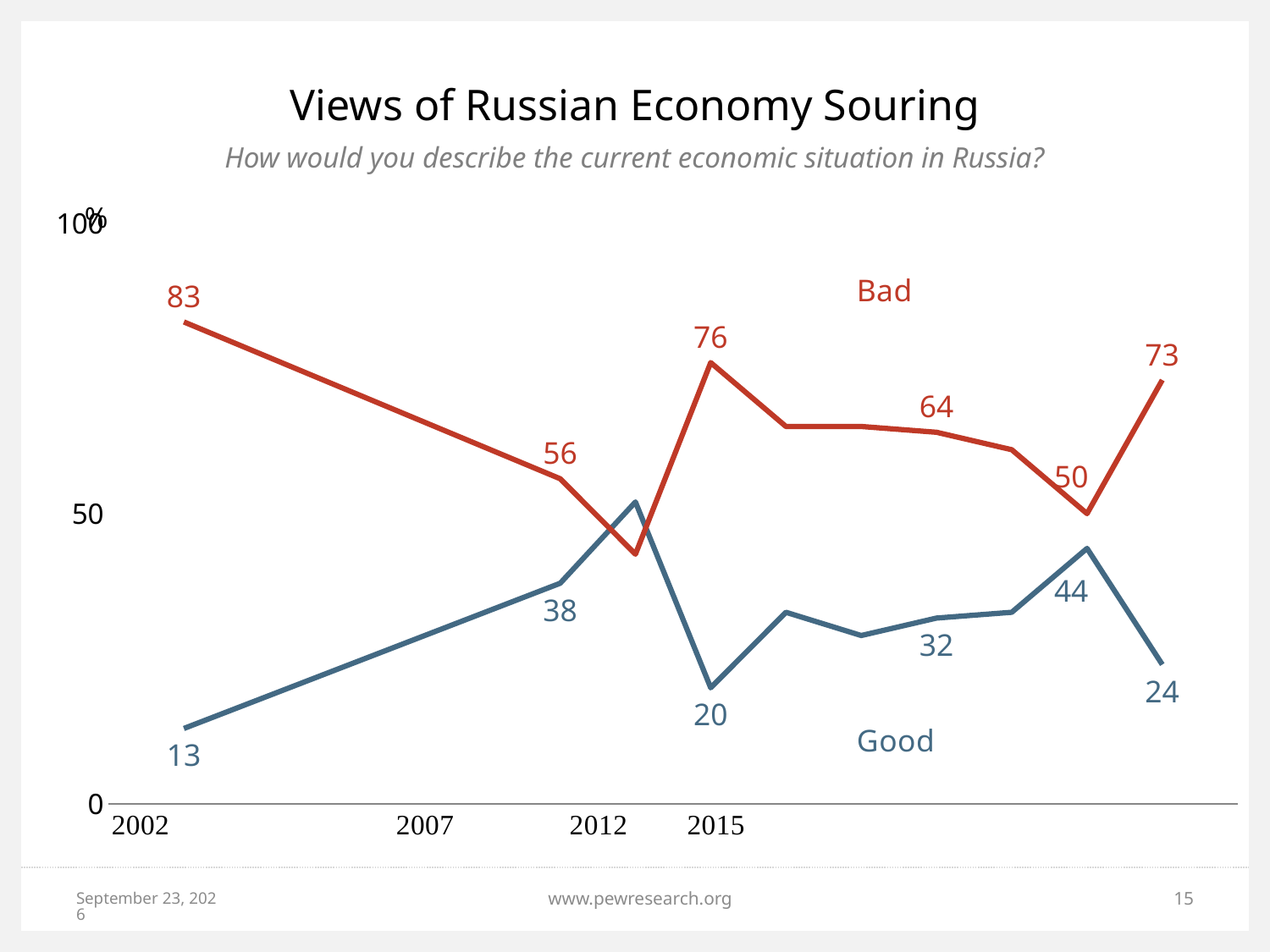
What kind of chart is shown on the slide? line chart Which is larger in 2015, the Bad value or the Good value? Bad What is the last labeled value of the Bad line, at the right end of the chart? 73 What is the value of the Bad line in 2002? 83 What is the difference between the Bad and Good values in 2002? 70 What is the value of the Good line in 2002? 13 What is the highest labeled value on the Bad line? 83 Does the Bad line rise or fall between 2002 and 2012? fall How many series are plotted on the chart? 2 What is the last labeled value of the Good line, at the right end of the chart? 24